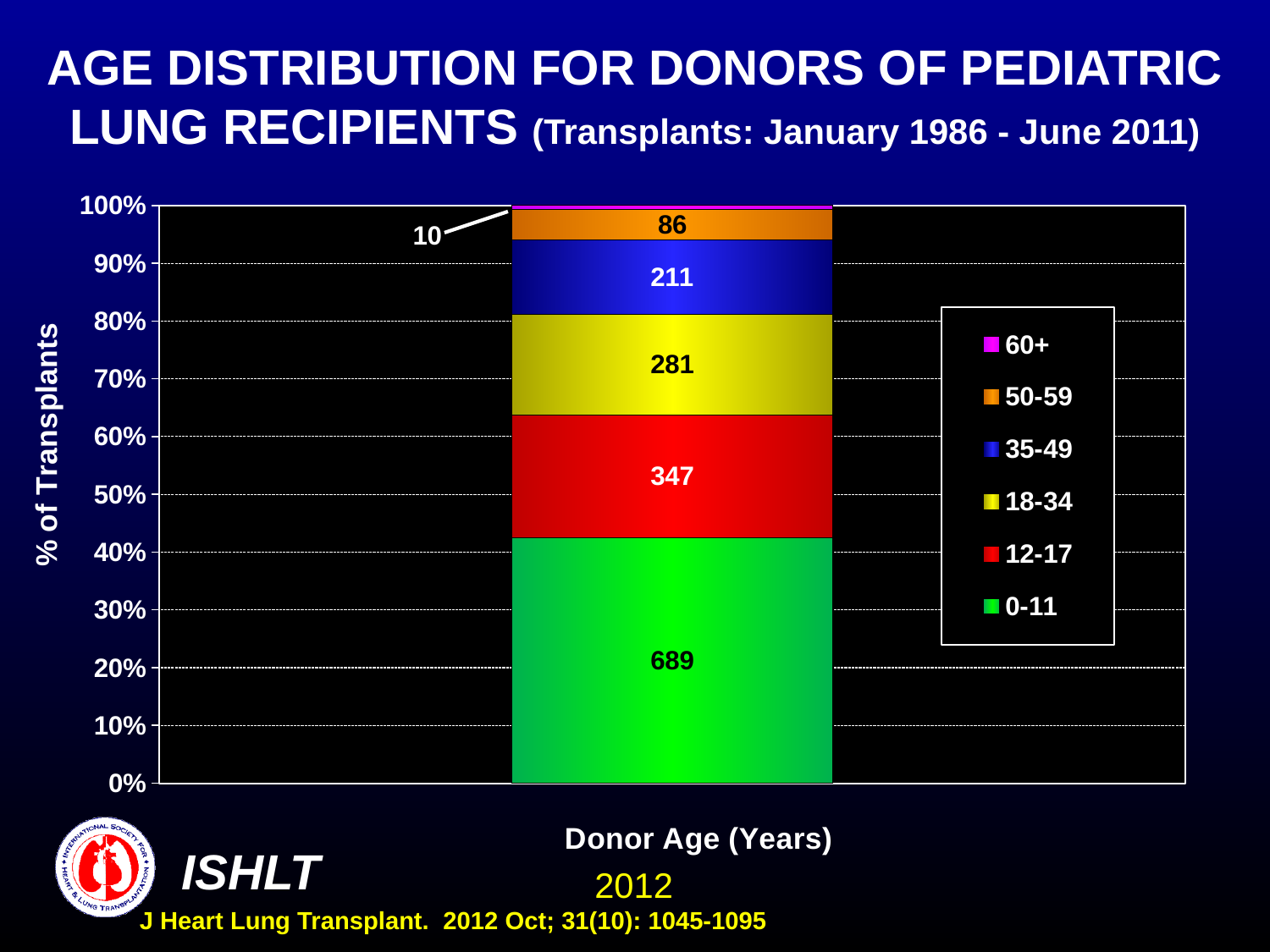
What is the label of the y axis? % of Transplants What kind of chart is shown on the slide? Stacked bar chart What is the number of donors in the 0-11 age group? 689 What is the number of donors in the 35-49 age group? 211 What is the difference between the number of donors aged 0-11 and those aged 12-17? 342 What is the number of donors in the 12-17 age group? 347 What is the total number of donors across all age groups in the stacked bar? 1624 Which has more donors: the 18-34 group or the 35-49 group? 18-34 What is the number of donors in the 60+ age group? 10 Which donor age group has the largest number of donors? 0-11 How many age groups does the legend list? 6 Which donor age group has the smallest number of donors? 60+